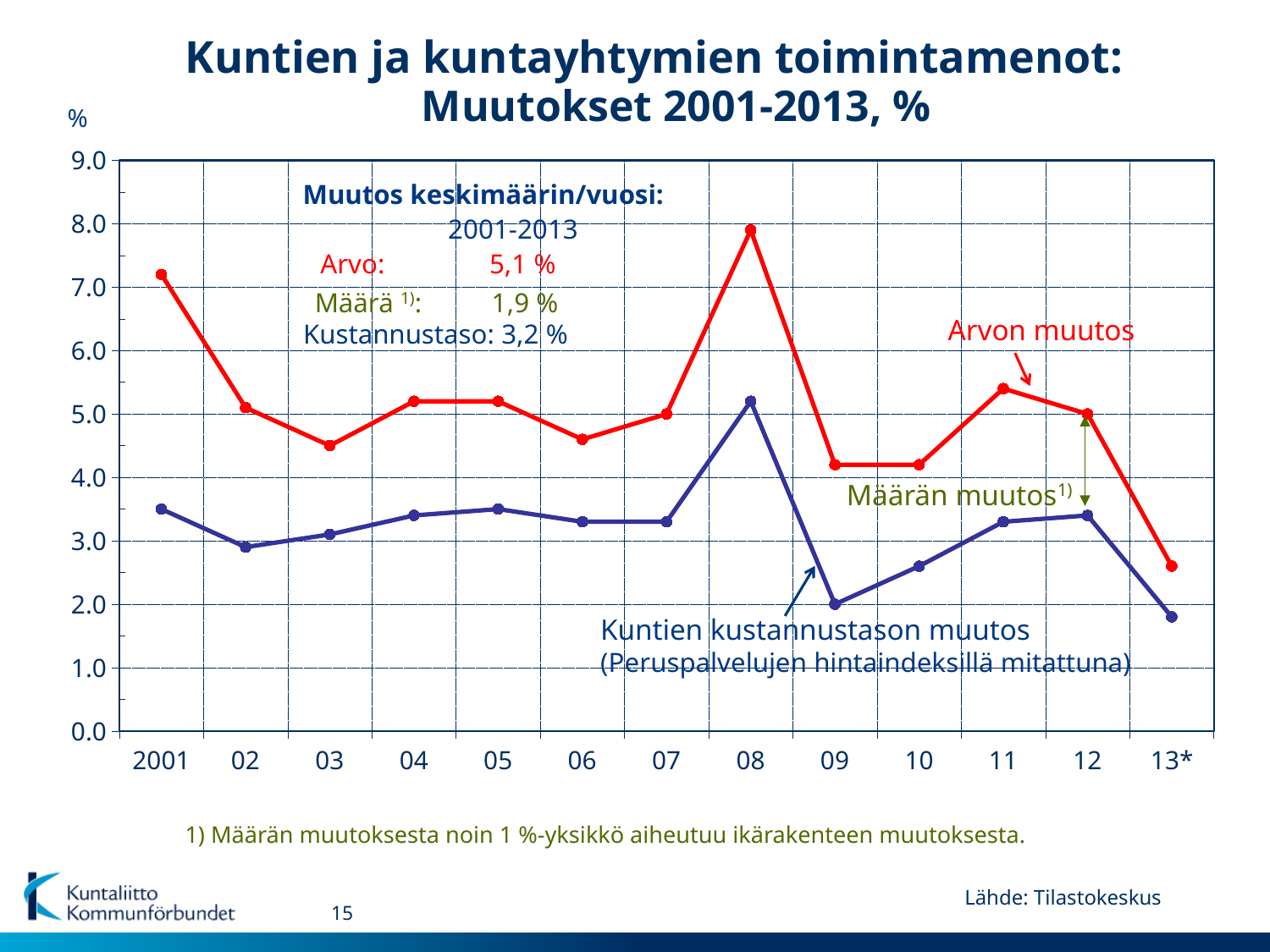
In which year does the Kuntien kustannustason muutos series reach its highest value? 08 Which series has the higher value in 2001, Arvon muutos or Kuntien kustannustason muutos? Arvon muutos Does the Arvon muutos series rise or fall from 2011 to 13*? fall In which year does the Arvon muutos series reach its lowest value? 13* How many data series are plotted in the chart? 2 How many years are plotted along the x axis? 13 What kind of chart is shown on the slide? line chart In which year does the Arvon muutos series reach its highest value? 08 Is the value of Arvon muutos in 13* greater or less than 3.0? less Is the value of Arvon muutos in 2008 greater or less than 7.0? greater Is the value of Kuntien kustannustason muutos in 2009 greater or less than 3.0? less According to the text box, what is the average annual change in Arvo for 2001-2013? 5,1 %